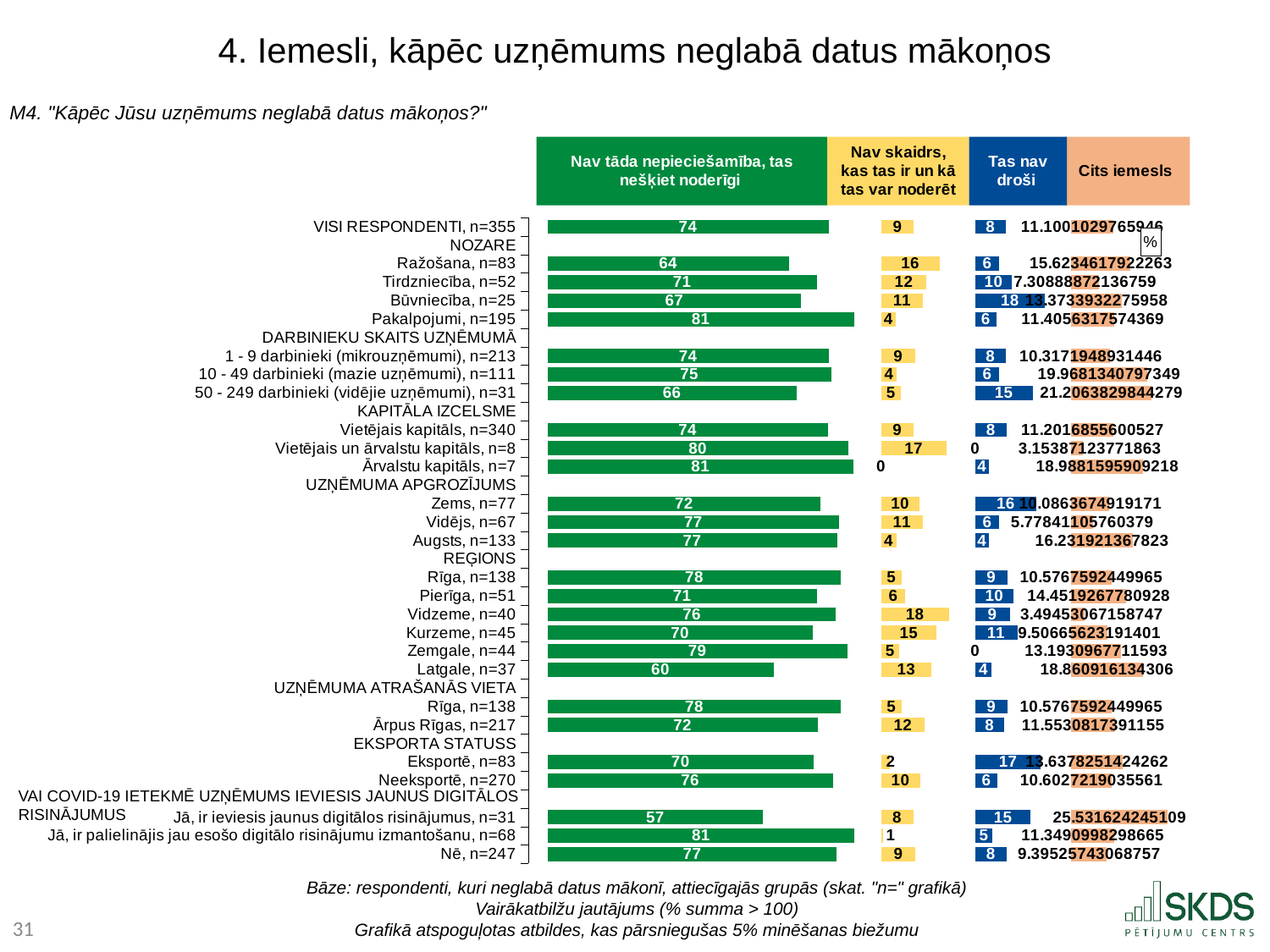
What is the value of "Tas nav droši" for Eksportē, n=83? 17 How many series does the chart legend list? 4 What is the difference between the "Nav skaidrs, kas tas ir un kā tas var noderēt" values for Vidzeme, n=40 and Kurzeme, n=45? 3 What is the value of "Nav tāda nepieciešamība, tas nešķiet noderīgi" for VISI RESPONDENTI, n=355? 74 Among the NOZARE groups, which has the highest value for "Nav tāda nepieciešamība, tas nešķiet noderīgi"? Pakalpojumi, n=195 Which has a larger value for "Nav tāda nepieciešamība, tas nešķiet noderīgi": Rīga, n=138 or Latgale, n=37? Rīga, n=138 What kind of chart is shown on the slide? Bar chart Which group has the lowest value for "Nav tāda nepieciešamība, tas nešķiet noderīgi" in the whole chart? Jā, ir ieviesis jaunus digitālos risinājumus, n=31 What colour represents the "Tas nav droši" series? Blue What is the difference between the "Nav tāda nepieciešamība, tas nešķiet noderīgi" values for Pakalpojumi, n=195 and Ražošana, n=83? 17 What is the value of "Nav skaidrs, kas tas ir un kā tas var noderēt" for Ražošana, n=83? 16 What is the value of "Nav tāda nepieciešamība, tas nešķiet noderīgi" for Pakalpojumi, n=195? 81